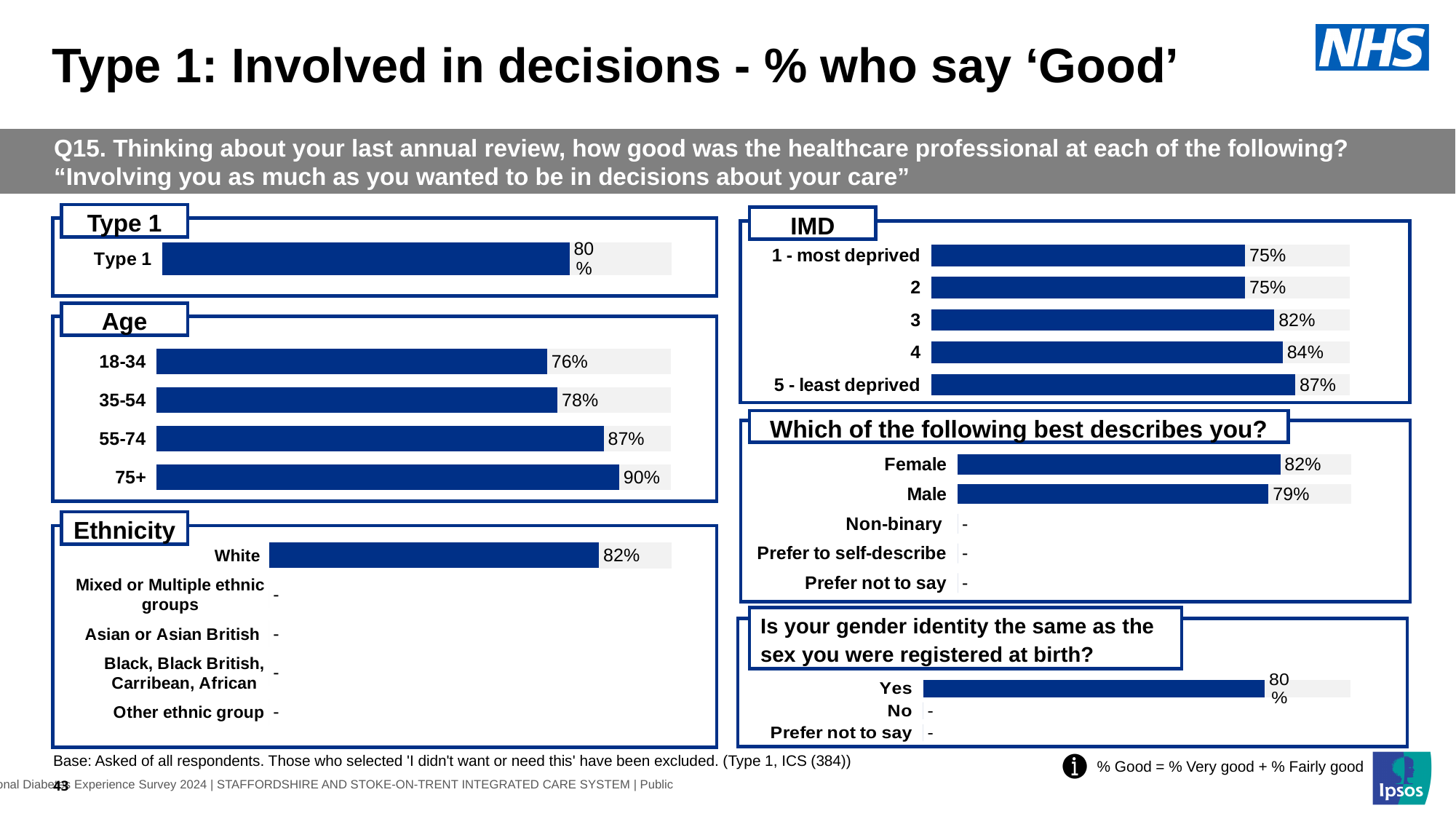
In the Age chart, do the values rise or fall as age increases from 18-34 to 75+? Rise In the 'Is your gender identity the same as the sex you were registered at birth?' chart, what is the value for Yes? 80% In the Age chart, how many age groups are shown? 4 In the IMD chart, what is the difference between the values for 4 and 1 - most deprived? 9 percentage points In the 'Which of the following best describes you?' chart, what is the value for Male? 79% In the Age chart, which age group has the lowest value? 18-34 What type of chart is used in the IMD panel? Bar chart In the IMD chart, which category has the highest value? 5 - least deprived In the Ethnicity chart, what is the value for White? 82% In the Age chart, what is the value for the 75+ group? 90% In the 'Which of the following best describes you?' chart, which is larger, the value for Female or for Male? Female In the IMD chart, what is the value for 5 - least deprived? 87%